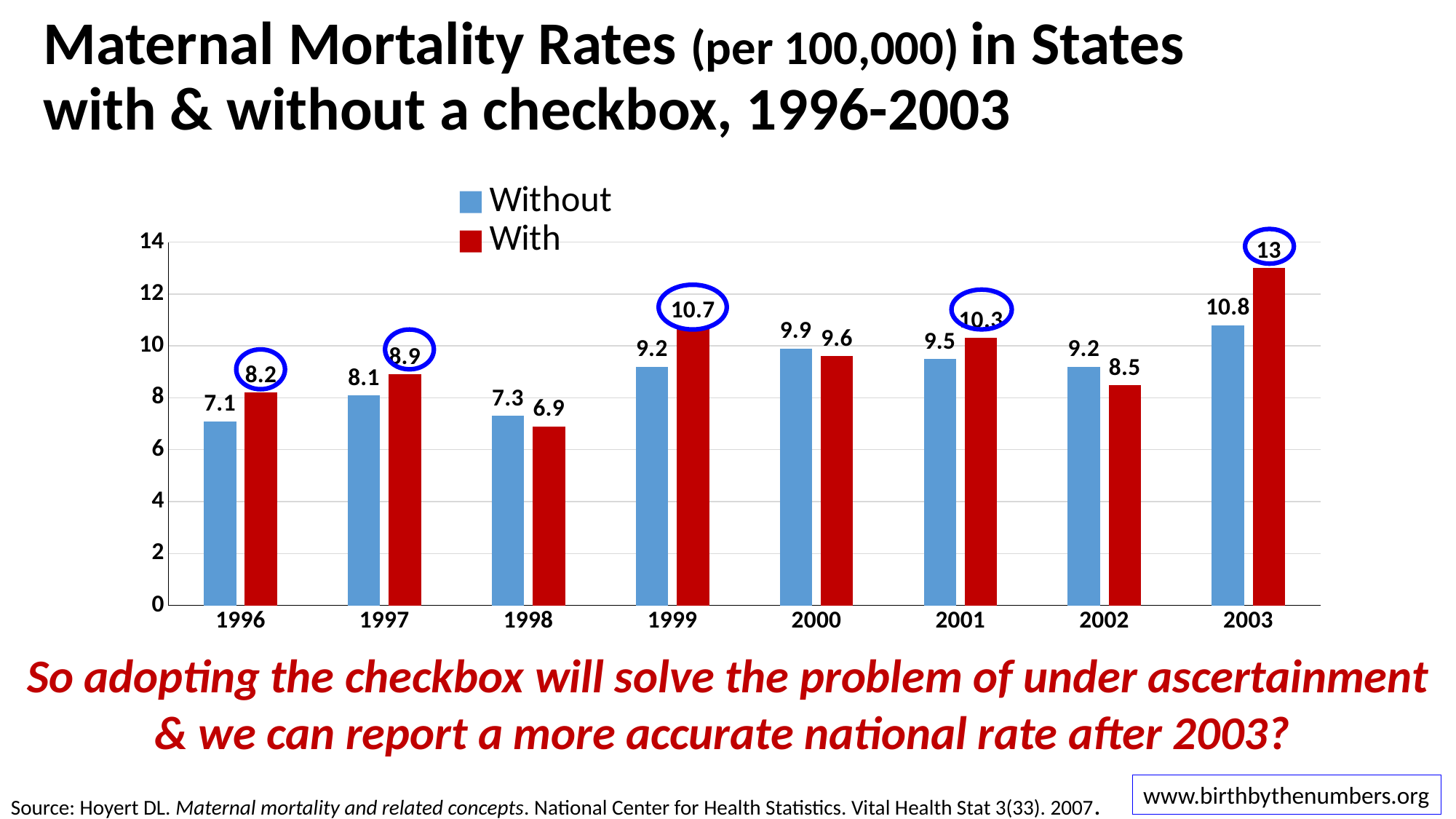
Is the value for the With series in 2001 greater or less than 10? greater What is the maternal mortality rate for states with a checkbox in 2003? 13 What kind of chart is shown on the slide? Bar chart What is the difference between the With and Without values in 2003? 2.2 Which year has the lowest value for the Without series? 1996 How many series does the legend list? 2 How many years are shown on the x axis? 8 What is the maternal mortality rate for states without a checkbox in 1996? 7.1 What is the value for the With series in 1999? 10.7 Which colour represents the With series in the legend? Red In 1998, which is larger: the Without value or the With value? Without Which year has the highest value for the With series? 2003